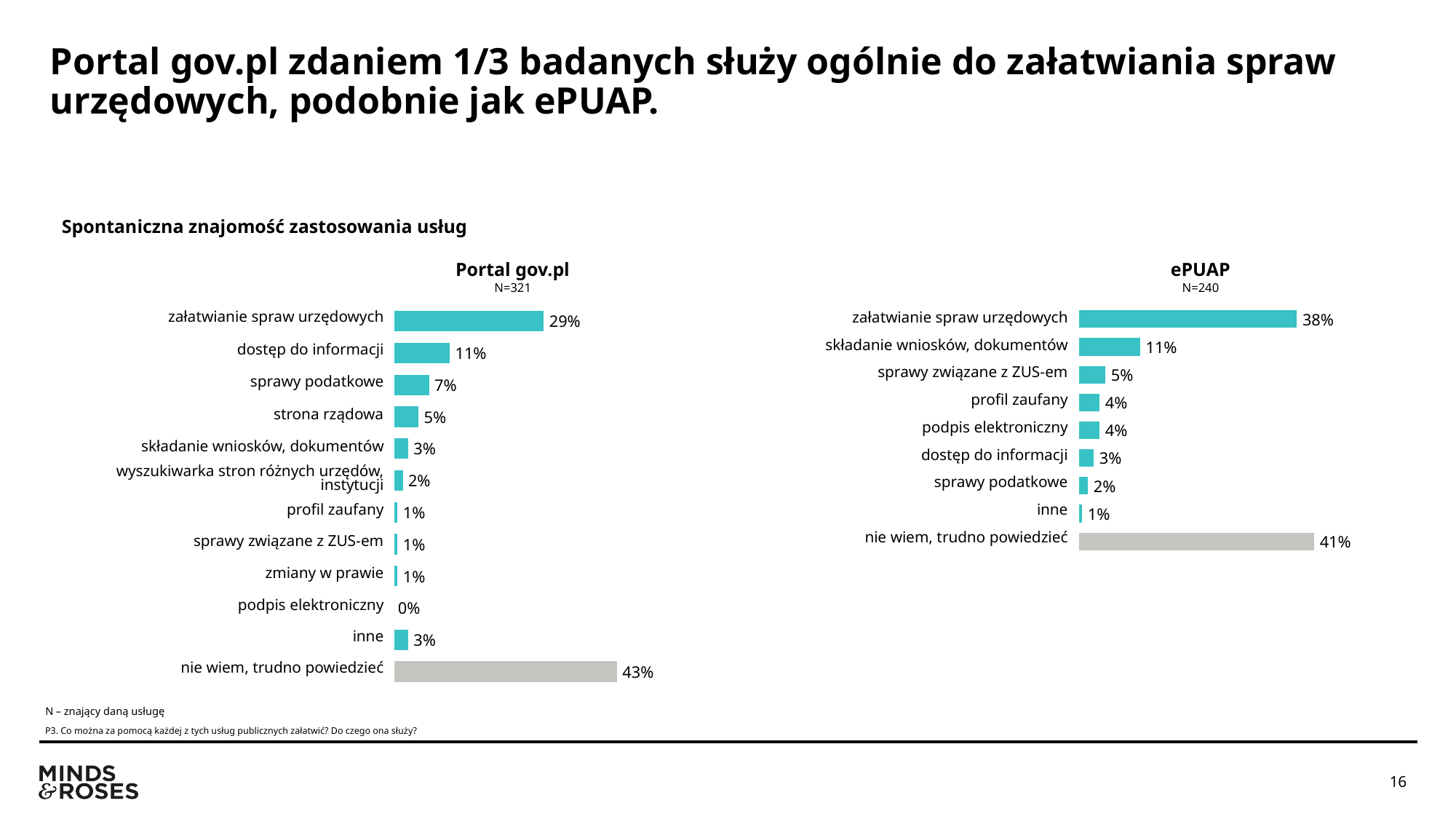
How many categories are shown in the ePUAP chart? 9 In the Portal gov.pl chart, which is larger: "sprawy podatkowe" or "strona rządowa"? sprawy podatkowe What is the difference between the "załatwianie spraw urzędowych" values in the ePUAP chart and the Portal gov.pl chart? 9 percentage points What is the sample size (N) shown for the ePUAP chart? N=240 In the ePUAP chart, what is the value for "składanie wniosków, dokumentów"? 11% In the Portal gov.pl chart, what is the value for "dostęp do informacji"? 11% In the Portal gov.pl chart, what is the value for "nie wiem, trudno powiedzieć"? 43% How many categories are shown in the Portal gov.pl chart? 12 In the Portal gov.pl chart, which category has the highest value? nie wiem, trudno powiedzieć What type of chart is the ePUAP chart? Bar chart In the ePUAP chart, which category has the lowest value? inne In the Portal gov.pl chart, which category has the lowest value? podpis elektroniczny